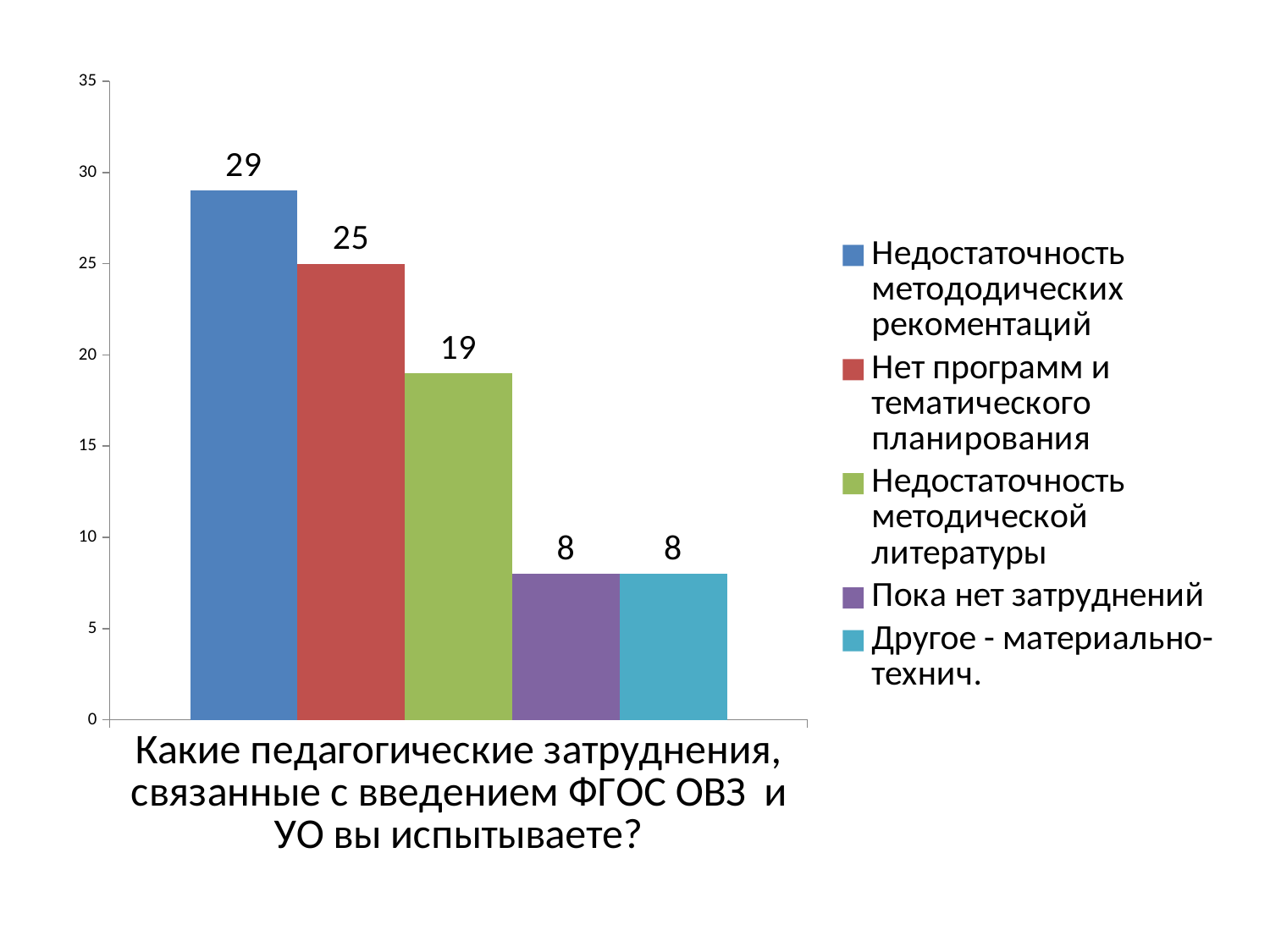
Do the values rise or fall from left to right across the bars? Fall What kind of chart is shown on the slide? Bar chart What is the value for "Недостаточность метододических рекоментаций"? 29 What is the value for "Недостаточность методической литературы"? 19 What colour is the bar for "Пока нет затруднений"? Purple What is the difference between the values for "Недостаточность метододических рекоментаций" and "Нет программ и тематического планирования"? 4 Which category has the highest value? Недостаточность метододических рекоментаций Which is larger: the value for "Нет программ и тематического планирования" or the value for "Недостаточность методической литературы"? Нет программ и тематического планирования What is the difference between the values for "Недостаточность методической литературы" and "Пока нет затруднений"? 11 What is the value for "Нет программ и тематического планирования"? 25 How many series does the legend list? 5 What is the value for "Пока нет затруднений"? 8